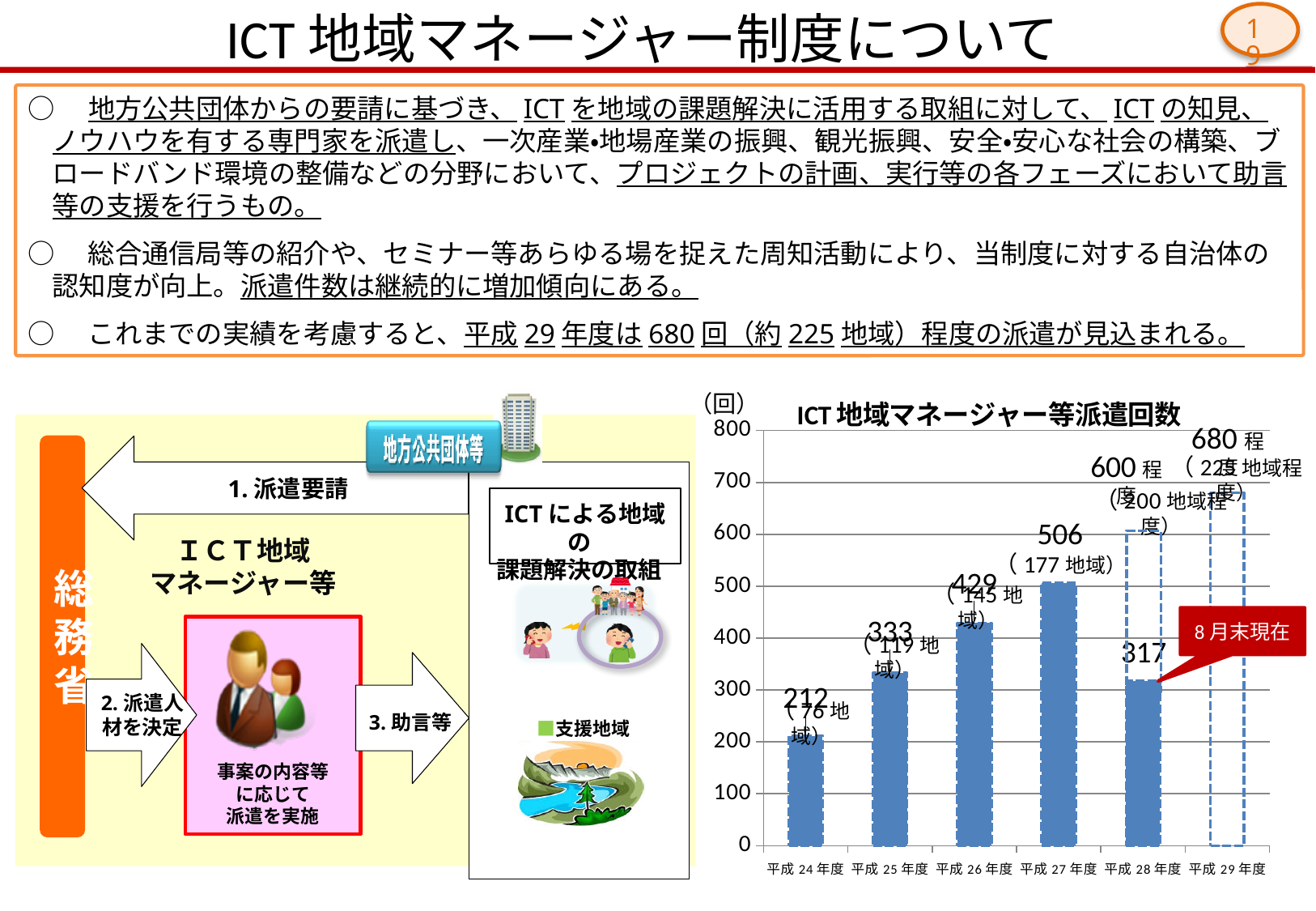
In the chart ICT地域マネージャー等派遣回数, do the values rise or fall from 平成24年度 to 平成27年度? rise What kind of chart is ICT地域マネージャー等派遣回数? bar chart In the chart ICT地域マネージャー等派遣回数, what is the value of the solid bar for 平成28年度 (8月末現在)? 317 In the chart ICT地域マネージャー等派遣回数, what is the value for 平成26年度? 429 In the chart ICT地域マネージャー等派遣回数, what is the value for 平成24年度? 212 In the chart ICT地域マネージャー等派遣回数, among the solid bars (actual results), which fiscal year has the highest value? 平成27年度 How many fiscal years are shown on the x axis of the chart ICT地域マネージャー等派遣回数? 6 In the chart ICT地域マネージャー等派遣回数, which fiscal year has the lowest value? 平成24年度 In the chart ICT地域マネージャー等派遣回数, is the solid bar for 平成28年度 greater or less than 400? less In the chart ICT地域マネージャー等派遣回数, what is the difference between the values for 平成27年度 and 平成24年度? 294 In the chart ICT地域マネージャー等派遣回数, which is larger, the value for 平成26年度 or 平成25年度? 平成26年度 In the chart ICT地域マネージャー等派遣回数, what is the value for 平成27年度? 506